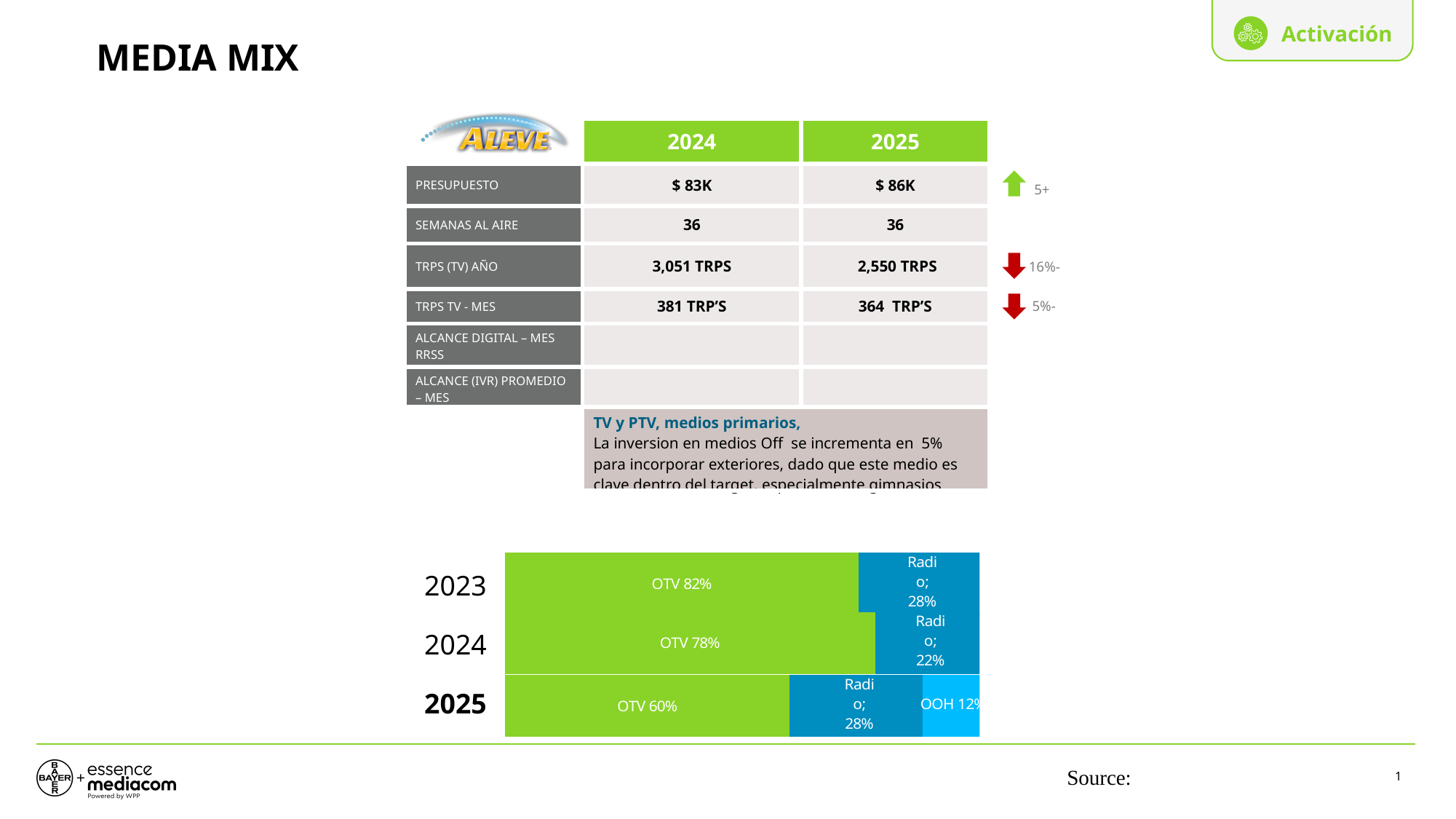
In the stacked bar chart, what is the difference between the OTV share in 2024 and in 2025? 18 percentage points What kind of chart is shown at the bottom of the slide? Stacked bar chart In the stacked bar chart, what is the total of the 2025 bar (OTV, Radio and OOH)? 100% In the stacked bar chart, what is the OTV share for 2023? 82% In the stacked bar chart, does the OTV share rise or fall from 2023 to 2025? Fall In the stacked bar chart, what is the OTV share for 2025? 60% In the stacked bar chart, which is larger for 2024: the OTV share or the Radio share? OTV In the stacked bar chart, what is the Radio share for 2024? 22% In the stacked bar chart, what is the OOH share for 2025? 12% How many years are shown in the stacked bar chart? 3 In the stacked bar chart, which year has the lowest OTV share? 2025 In the stacked bar chart, which year has the highest OTV share? 2023